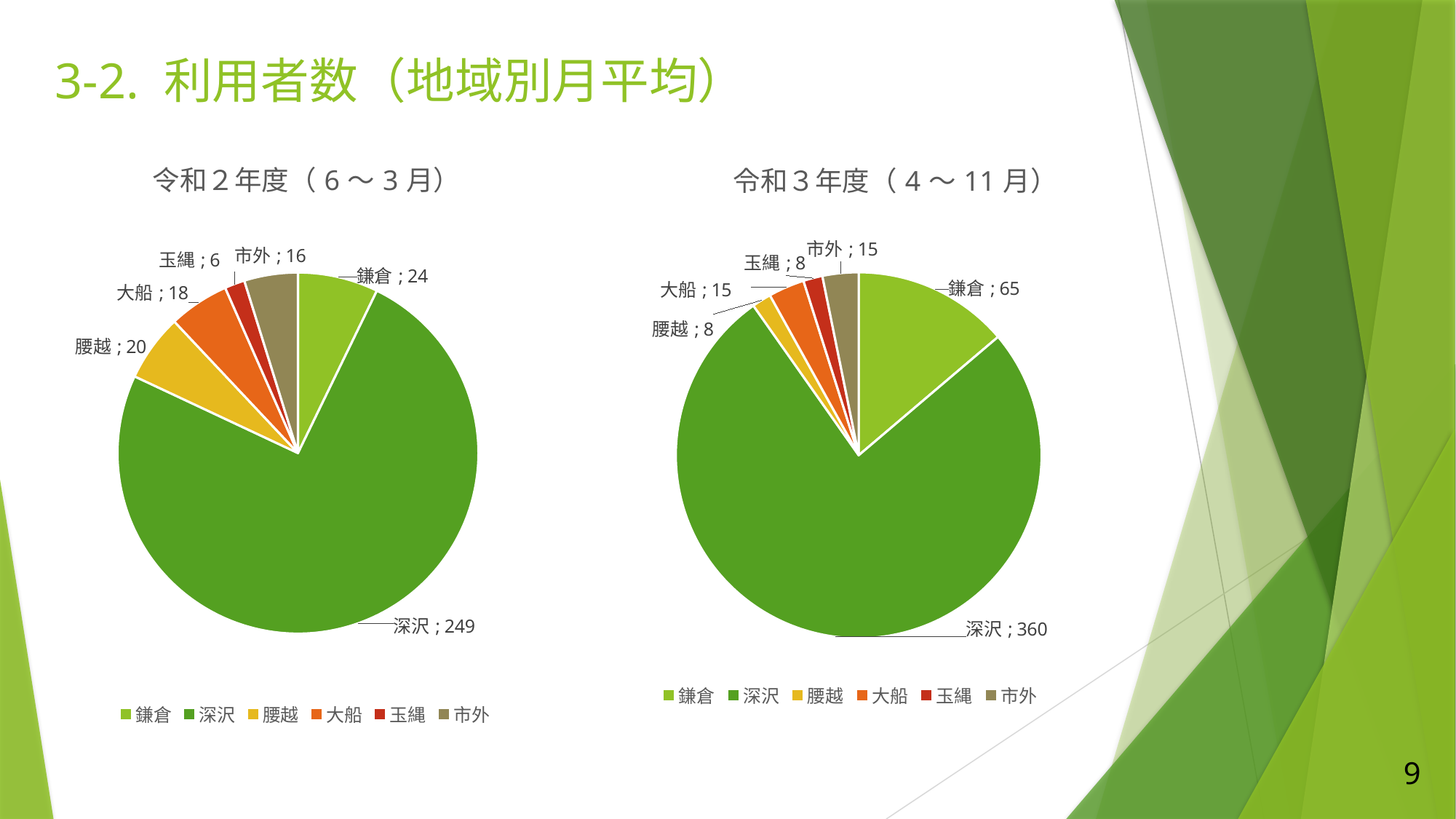
What kind of chart is the 令和２年度（６～３月） chart? pie chart How many categories does the 令和３年度（４～11月） pie chart show? 6 In the 令和３年度（４～11月） pie chart, what is the value for 市外? 15 In the 令和２年度（６～３月） pie chart, what is the value for 腰越? 20 In the 令和２年度（６～３月） pie chart, what is the value for 深沢? 249 In the 令和３年度（４～11月） pie chart, what is the difference between 深沢 and 鎌倉? 295 In the 令和２年度（６～３月） pie chart, which category has the smallest value? 玉縄 In the 令和３年度（４～11月） pie chart, which category has the largest value? 深沢 In the 令和２年度（６～３月） pie chart, what is the difference between 鎌倉 and 大船? 6 In the 令和３年度（４～11月） pie chart, what is the value for 鎌倉? 65 In the 令和２年度（６～３月） pie chart, which is larger, 腰越 or 市外? 腰越 What is the title of the chart on the right side of the slide? 令和３年度（４～11月）